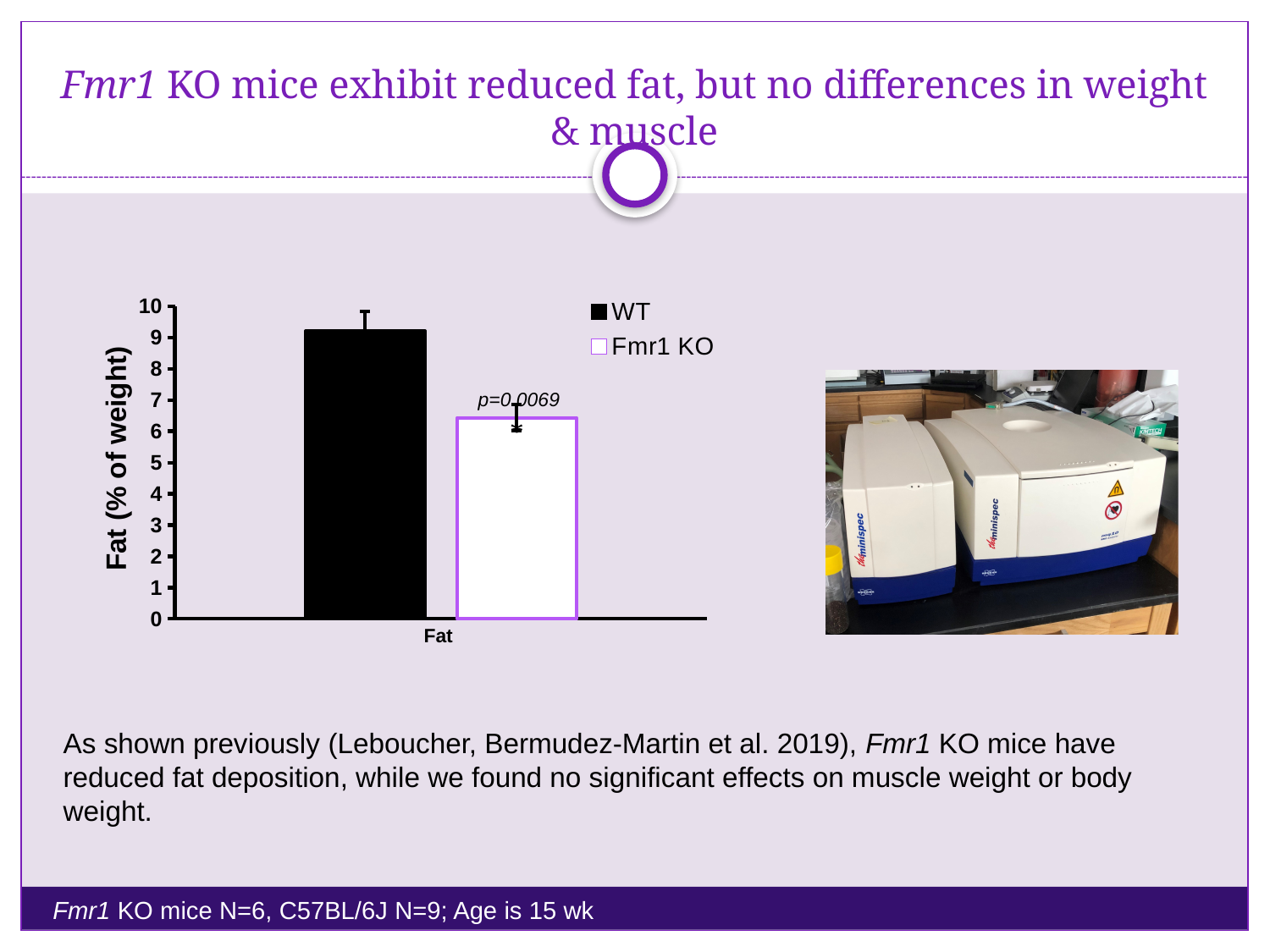
How many series does the chart's legend list? 2 What p-value is printed above the Fmr1 KO bar in the chart? p=0.0069 Is the fat percentage for Fmr1 KO greater or less than 7? less Which series has the highest fat percentage in the chart? WT Which series has the higher fat percentage, WT or Fmr1 KO? WT How many categories are shown on the x axis of the chart? 1 Is the fat percentage for Fmr1 KO greater or less than 5? greater What kind of chart is shown on the slide? bar chart What is the label of the y axis of the chart? Fat (% of weight) Which series has the lowest fat percentage in the chart? Fmr1 KO Is the fat percentage for WT greater or less than 8? greater